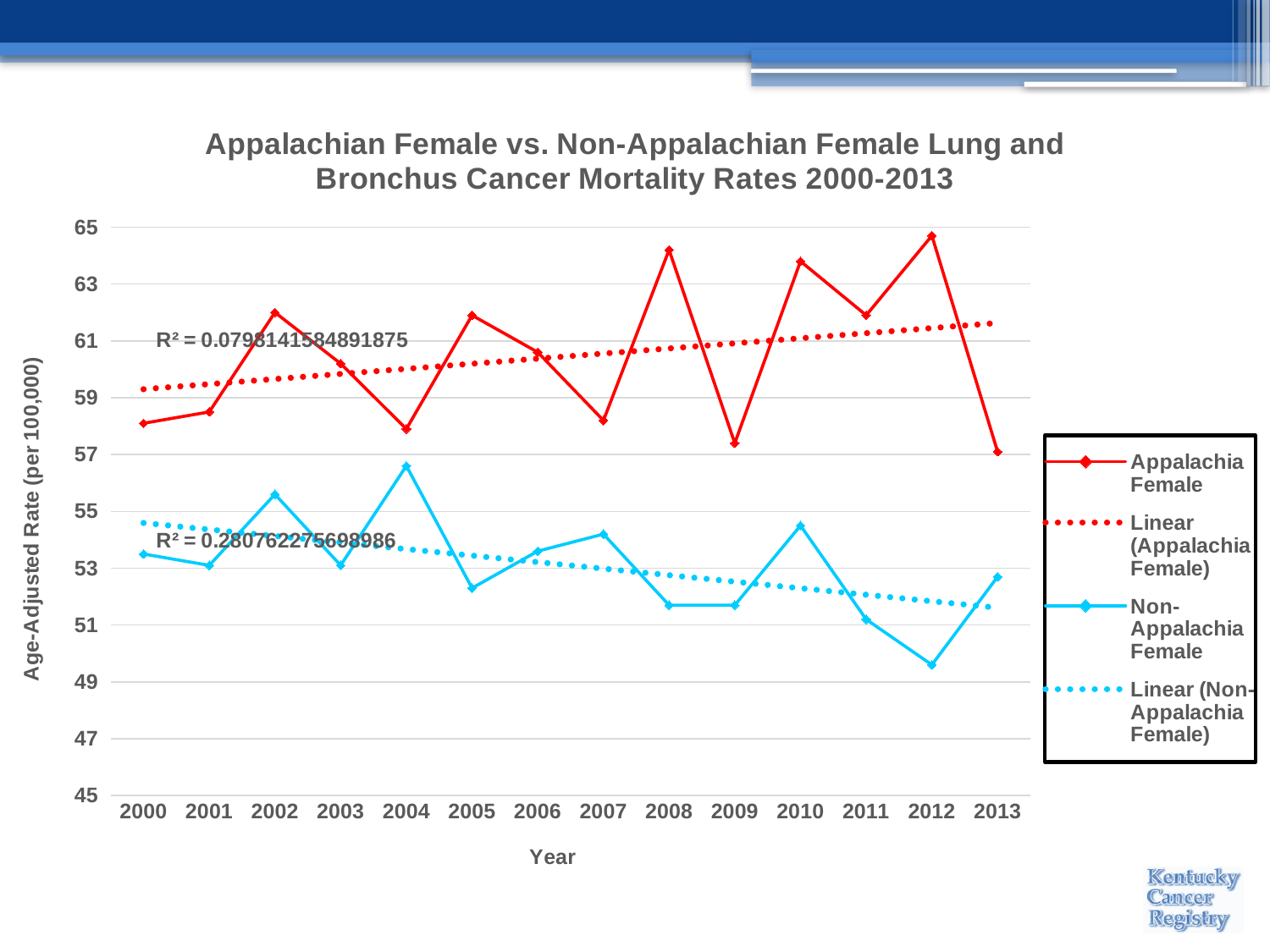
What is the label of the y axis? Age-Adjusted Rate (per 100,000) How many years are plotted along the x axis? 14 In which year is the Appalachia Female mortality rate highest? 2012 Does the Linear (Non-Appalachia Female) trendline rise or fall from 2000 to 2013? Fall In which year is the Non-Appalachia Female mortality rate highest? 2004 Is the Appalachia Female value for 2008 greater or less than 63? greater Which year has the larger Appalachia Female value, 2002 or 2003? 2002 In which year is the Non-Appalachia Female mortality rate lowest? 2012 Is the Appalachia Female value for 2013 greater or less than 59? less How many entries does the legend list? 4 Is the Non-Appalachia Female value for 2012 greater or less than 51? less What kind of chart is shown on the slide? Line chart